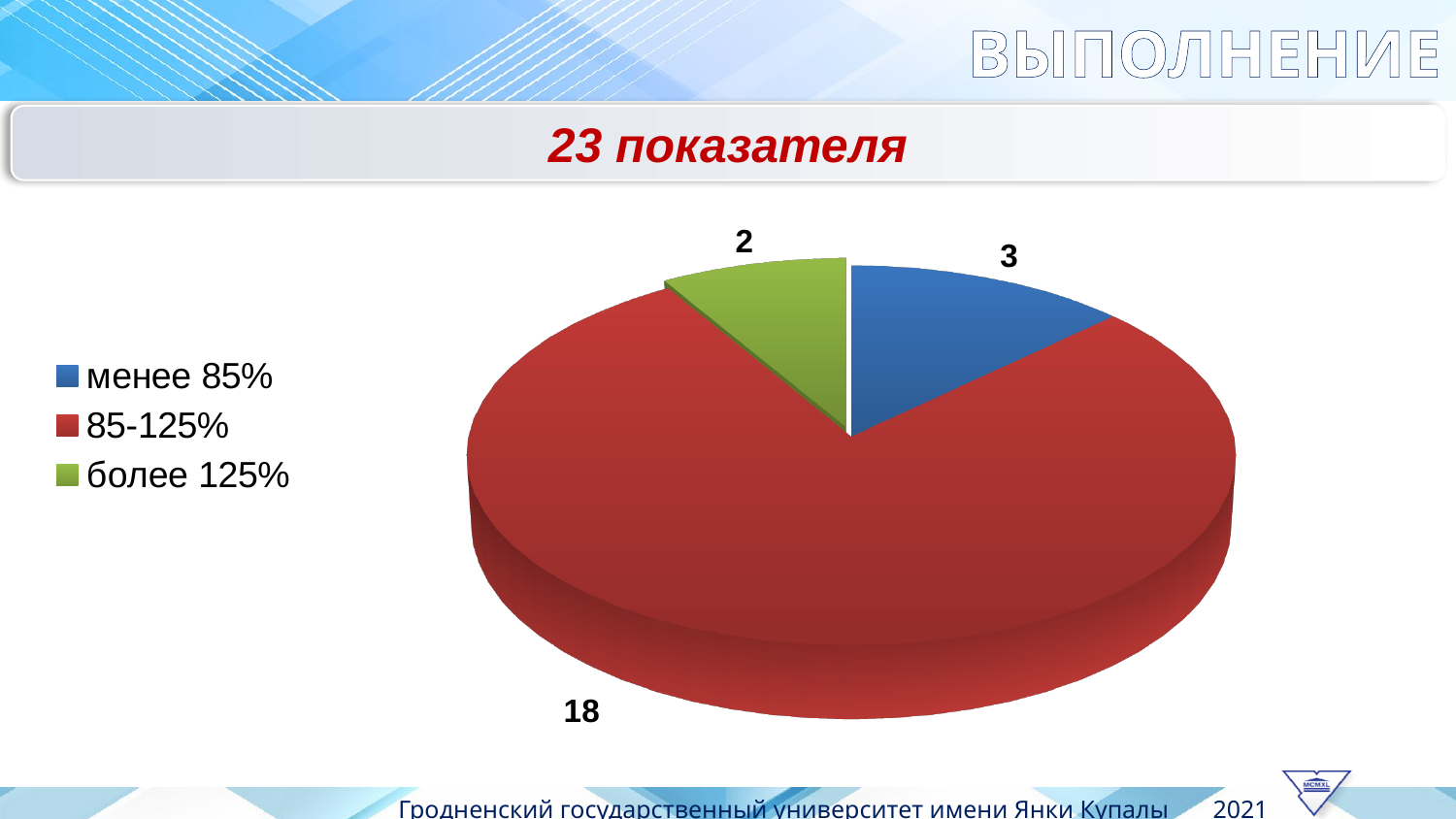
What is the value for the slice labelled более 125%? 2 What is the value for the slice labelled 85-125%? 18 Which category has the largest slice of the pie? 85-125% How many entries does the legend list? 3 How many slices does the pie chart have? 3 What is the difference between the values for 85-125% and менее 85%? 15 What colour is the slice for 85-125%? red Which category has the smallest slice of the pie? более 125% What kind of chart is shown on the slide? pie chart What is the total of all the slices in the pie chart? 23 What is the value for the slice labelled менее 85%? 3 Which is larger, the value for менее 85% or the value for более 125%? менее 85%